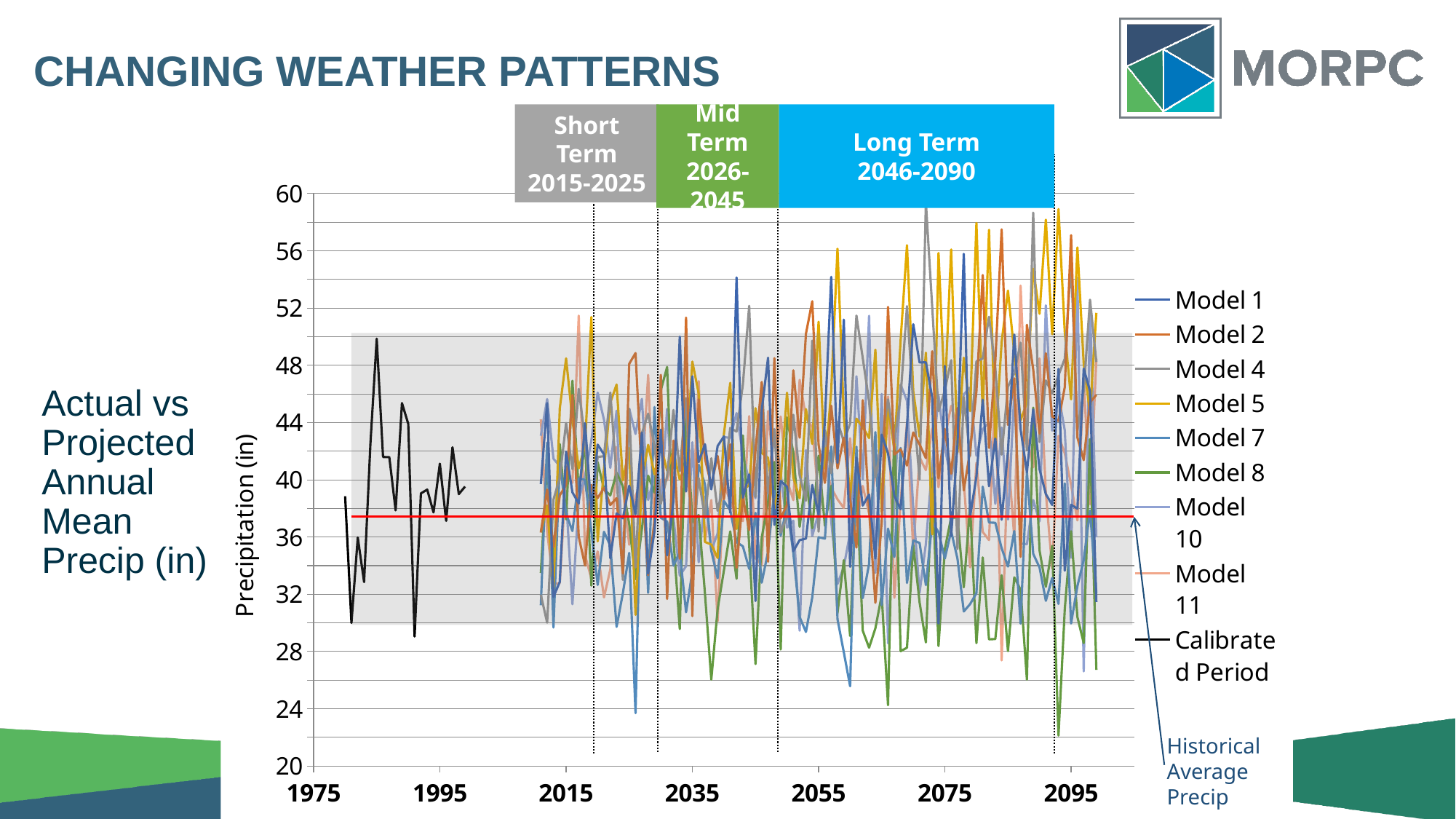
What years does the Short Term period cover according to the chart? 2015-2025 What is the first year label on the horizontal axis of the chart? 1975 Is the Historical Average Precip line greater or less than 40 inches? less Is the Historical Average Precip line greater or less than 36 inches? greater How many series does the chart's legend list? 9 What is the highest value shown on the vertical axis of the chart? 60 What kind of chart is shown on the slide? line chart